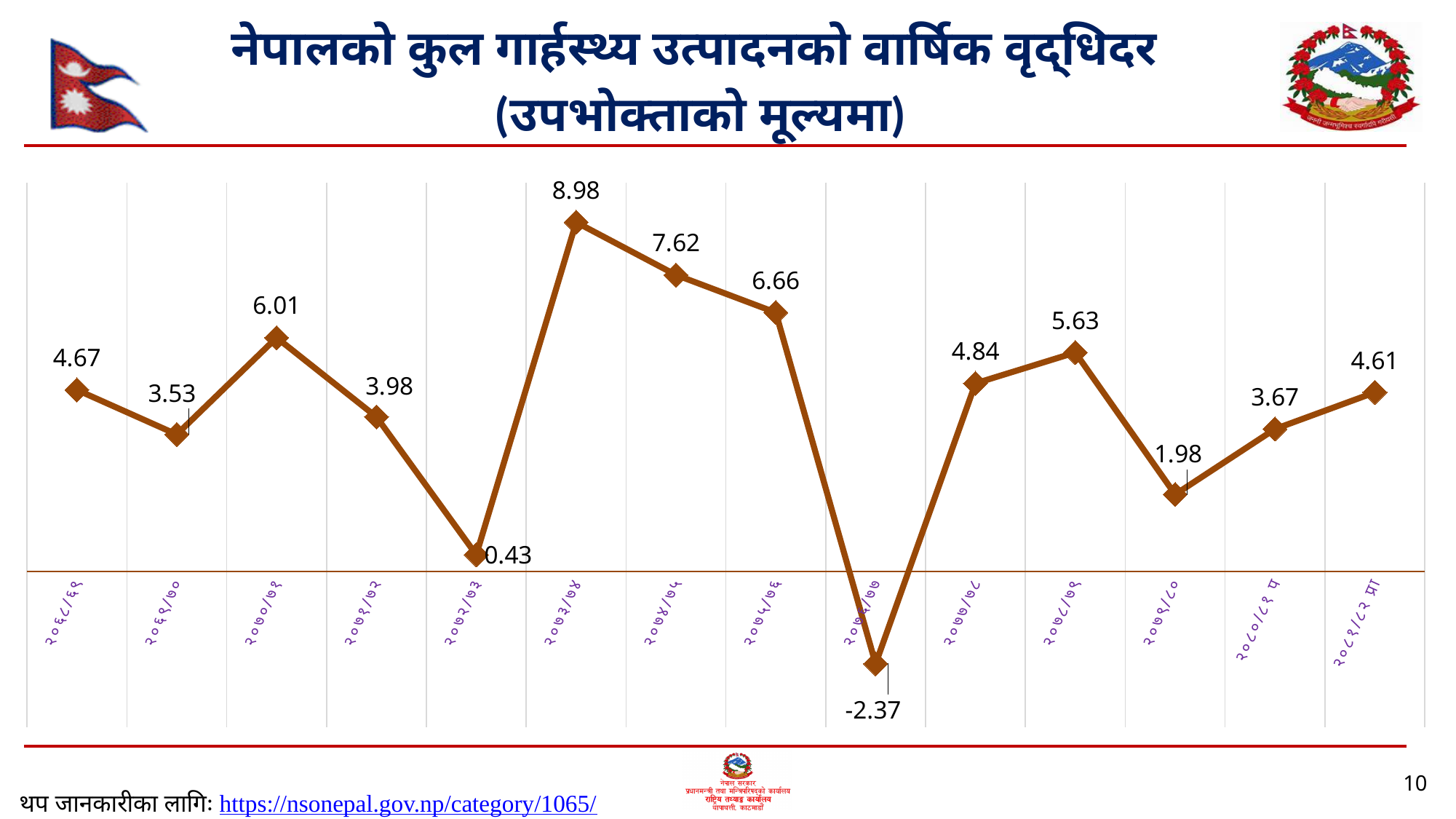
What is the value for the last point, २०८१/८२ प्रा? 4.61 What kind of chart is shown on the slide? line chart What is the difference between the values for २०७०/७१ and २०६९/७०? 2.48 What is the value for २०७९/८०? 1.98 What is the difference between the values for २०७३/७४ and २०७४/७५? 1.36 Do the values rise or fall from २०७३/७४ to २०७५/७६? fall What is the value for २०७०/७१? 6.01 Which is larger, the value for २०७७/७८ or the value for २०७८/७९? २०७८/७९ What is the value for २०७६/७७? -2.37 How many data points are plotted on the line chart? 14 Which year has the lowest value on the chart? २०७६/७७ Which year has the highest value on the chart? २०७३/७४